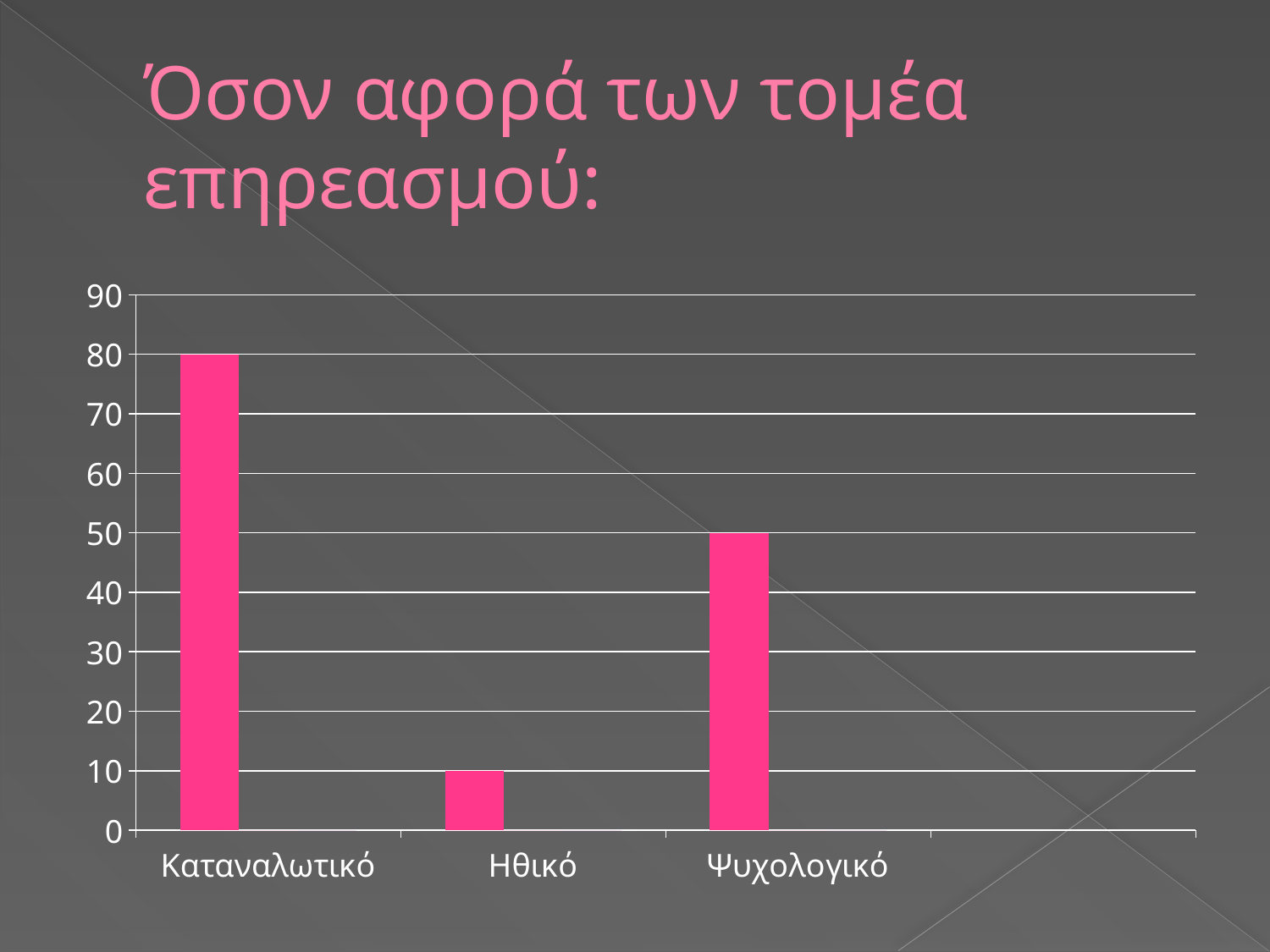
Is the value for Ψυχολογικό greater or less than 60? less What colour are the bars in the chart? pink What is the value for Ηθικό? 10 What is the difference between the values for Ψυχολογικό and Ηθικό? 40 Which is larger, the value for Ψυχολογικό or the value for Ηθικό? Ψυχολογικό What is the value for Καταναλωτικό? 80 What is the difference between the values for Καταναλωτικό and Ψυχολογικό? 30 Which category has the highest value? Καταναλωτικό What kind of chart is shown on the slide? bar chart What is the value for Ψυχολογικό? 50 Which category has the lowest value? Ηθικό How many categories are shown on the x axis? 3